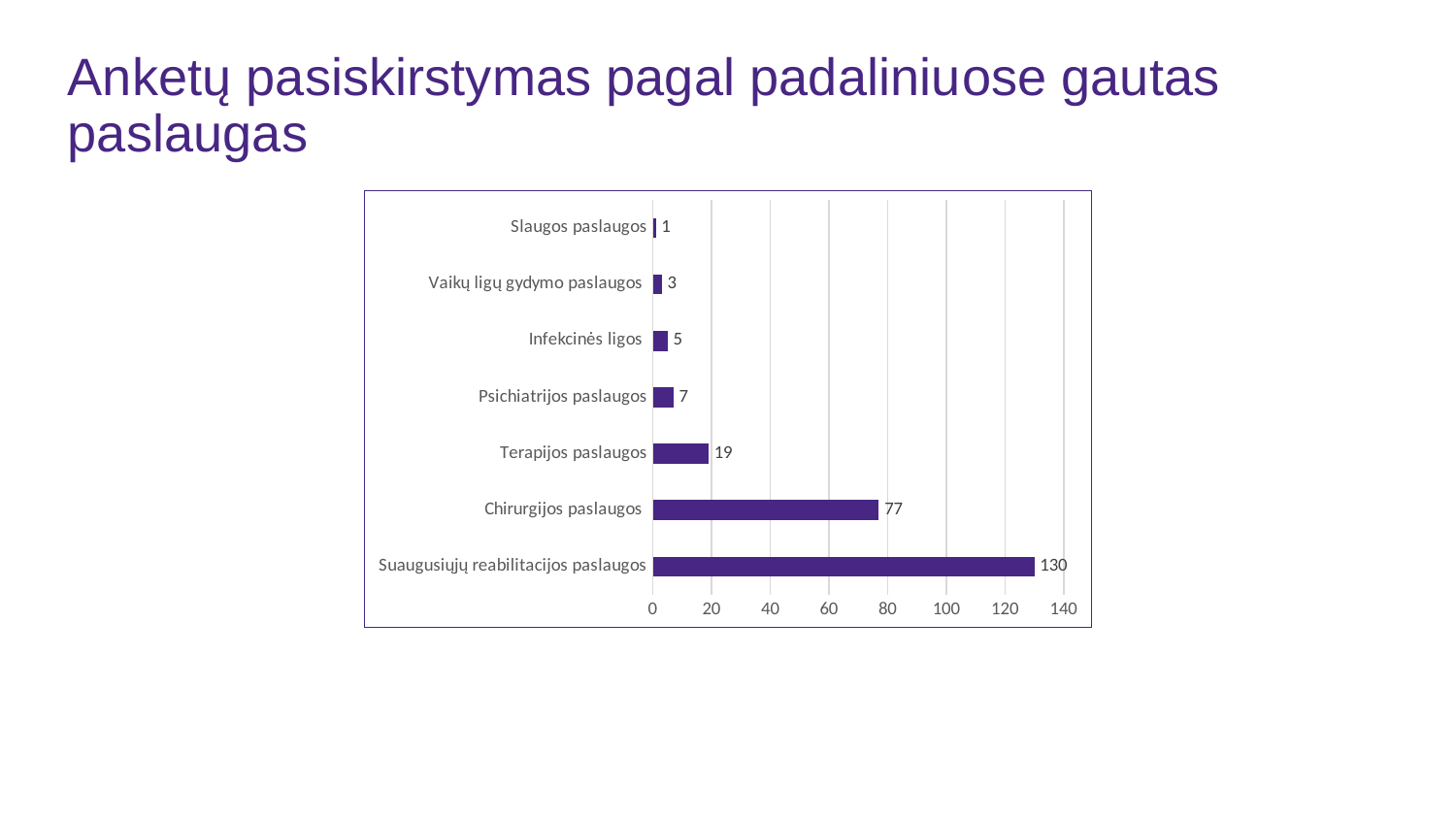
What is the difference between the values for Suaugusiųjų reabilitacijos paslaugos and Chirurgijos paslaugos? 53 Which is larger, the value for Psichiatrijos paslaugos or the value for Vaikų ligų gydymo paslaugos? Psichiatrijos paslaugos What is the value for Infekcinės ligos? 5 What kind of chart is shown on the slide? bar chart Which category has the lowest value? Slaugos paslaugos What is the difference between the values for Terapijos paslaugos and Psichiatrijos paslaugos? 12 Which category has the highest value? Suaugusiųjų reabilitacijos paslaugos How many categories are shown in the chart? 7 Is the value for Chirurgijos paslaugos greater or less than 60? greater What is the value for Terapijos paslaugos? 19 What is the highest value shown on the horizontal axis? 140 What is the value for Chirurgijos paslaugos? 77